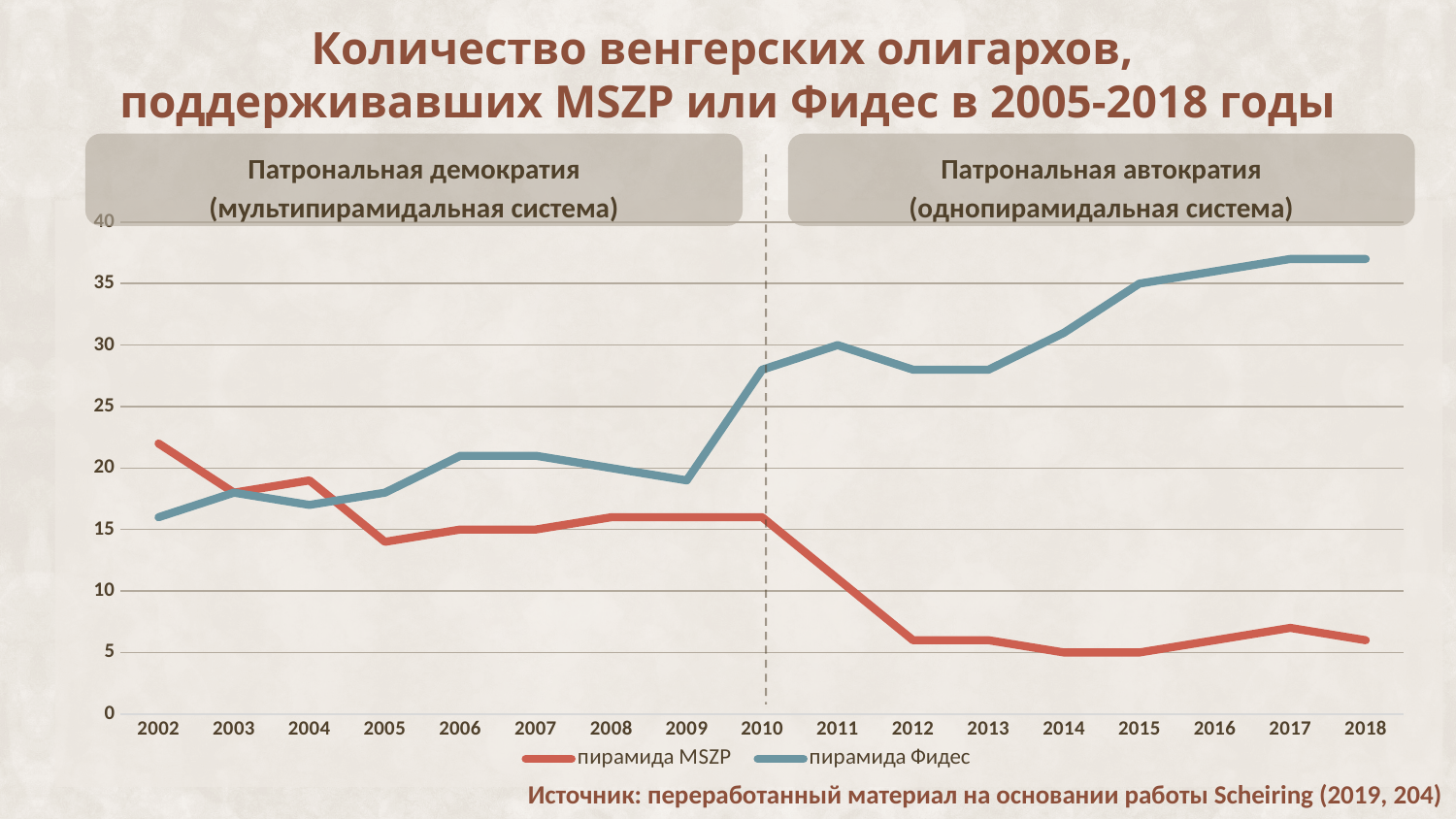
How many years are shown on the x axis? 17 Which series is drawn in red? пирамида MSZP What is the value for пирамида MSZP in 2014? 5 What is the value for пирамида Фидес in 2011? 30 Is the value for пирамида Фидес in 2018 greater or less than 35? greater What kind of chart is shown on the slide? line chart Is the value for пирамида MSZP in 2002 greater or less than 20? greater What is the value for пирамида Фидес in 2015? 35 Is the value for пирамида MSZP in 2012 greater or less than 10? less How many series does the legend list? 2 Which series has the higher value in 2018, пирамида MSZP or пирамида Фидес? пирамида Фидес Does the value for пирамида MSZP rise or fall from 2010 to 2012? fall